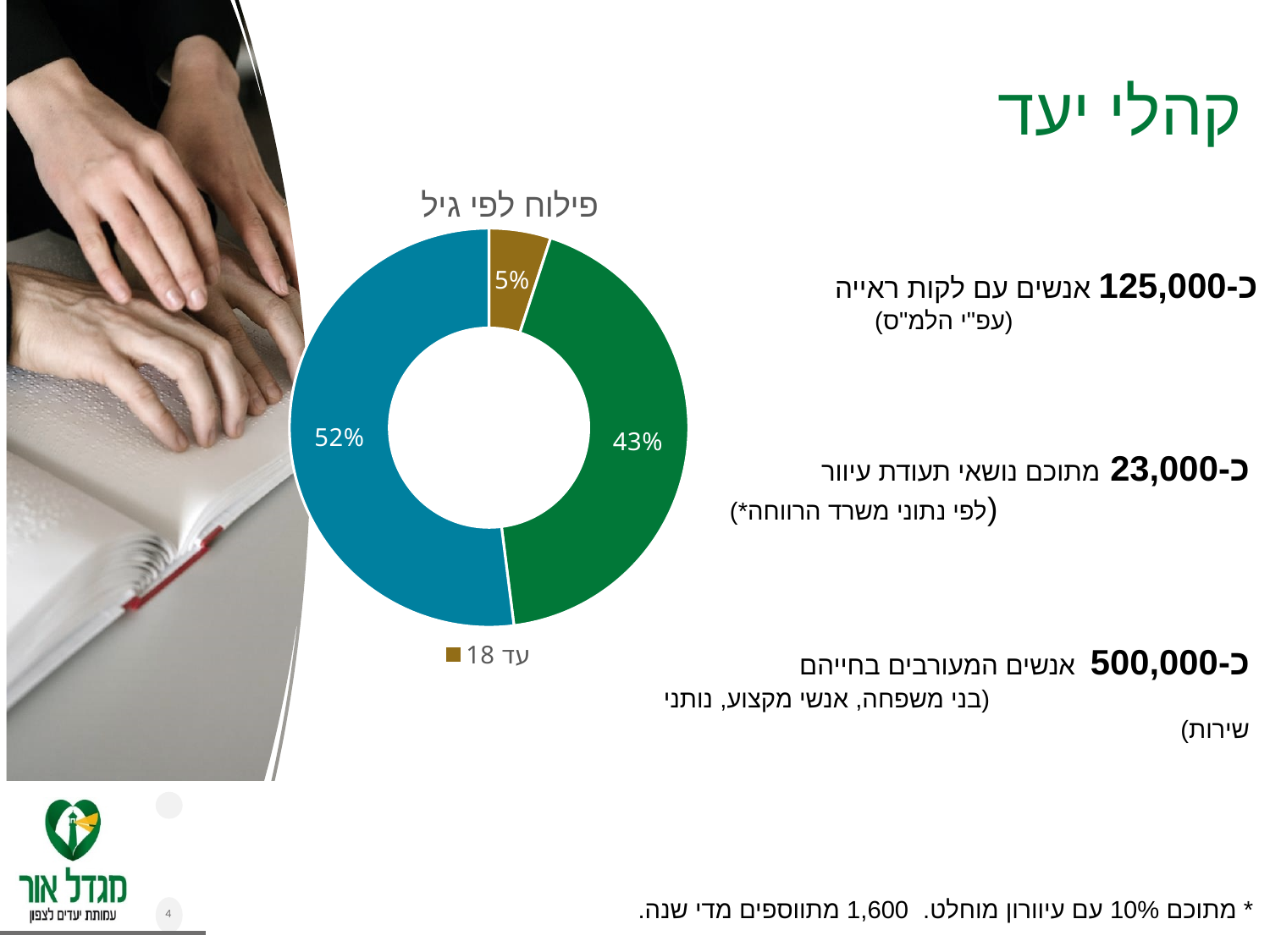
What percentage is shown for the 'עד 18' slice? 5% How many slices does the chart have? 3 What is the largest percentage shown on the chart? 52% Which slice is larger, the blue one or the green one? The blue one (52%) How many entries does the chart legend show? 1 What is the smallest percentage shown on the chart? 5% What is the title of the chart? פילוח לפי גיל What percentage is shown on the green slice? 43% What is the difference in percentage points between the blue slice and the green slice? 9 percentage points What kind of chart is shown on the slide? Doughnut (pie) chart What colour is the 'עד 18' slice? Gold/brown What percentage is shown on the blue slice? 52%